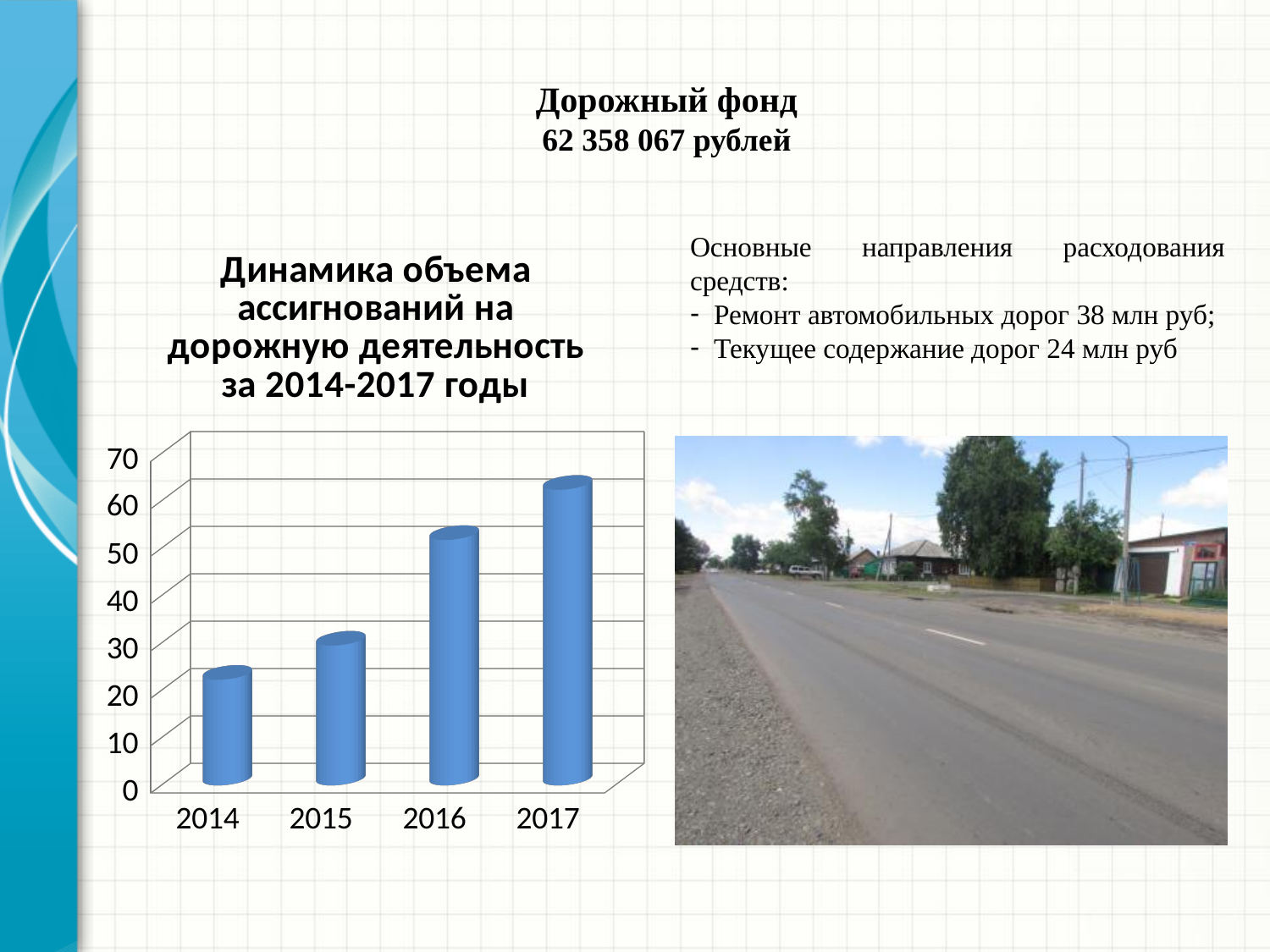
Is the value for 2017 greater or less than 50? greater How many years (categories) are plotted on the chart? 4 Is the value for 2014 greater or less than 30? less Is the value for 2015 greater or less than 40? less Which year has the lowest bar on the chart? 2014 Which year has the highest bar on the chart? 2017 What is the title of the chart? Динамика объема ассигнований на дорожную деятельность за 2014-2017 годы Do the values rise or fall from 2014 to 2017? rise Which is larger, the value for 2016 or the value for 2015? 2016 What colour are the bars on the chart? blue What kind of chart is shown on the slide? bar chart